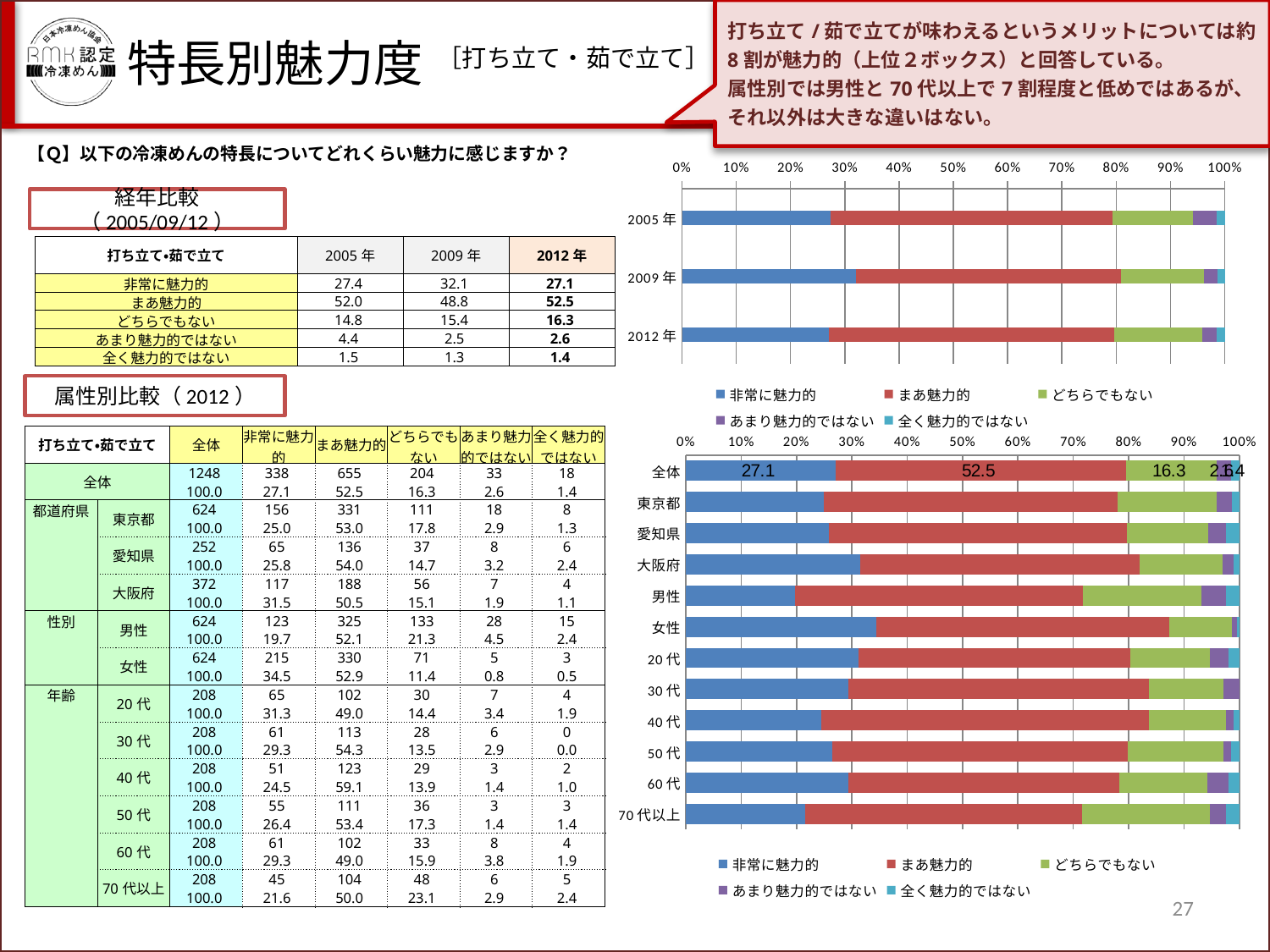
On the bottom chart (属性別比較), is the 非常に魅力的 value for 男性 greater or less than 30%? less How many categories are shown on the bottom chart (属性別比較)? 12 On the bottom chart (属性別比較), what is the 非常に魅力的 value for 全体? 27.1 On the bottom chart (属性別比較), what is the difference between the まあ魅力的 and 非常に魅力的 values for 全体? 25.4 On the top chart (経年比較), which year has the longest 非常に魅力的 segment? 2009年 On the bottom chart (属性別比較), what is the まあ魅力的 value for 全体? 52.5 How many categories (years) are shown on the top chart (経年比較)? 3 On the top chart (経年比較), is the 非常に魅力的 value for 2009年 greater or less than 20%? greater On the bottom chart (属性別比較), which has the larger 非常に魅力的 segment, 男性 or 女性? 女性 On the bottom chart (属性別比較), what is the どちらでもない value for 全体? 16.3 What type of chart is the top chart (経年比較)? bar chart How many series does the legend of the top chart (経年比較) list? 5